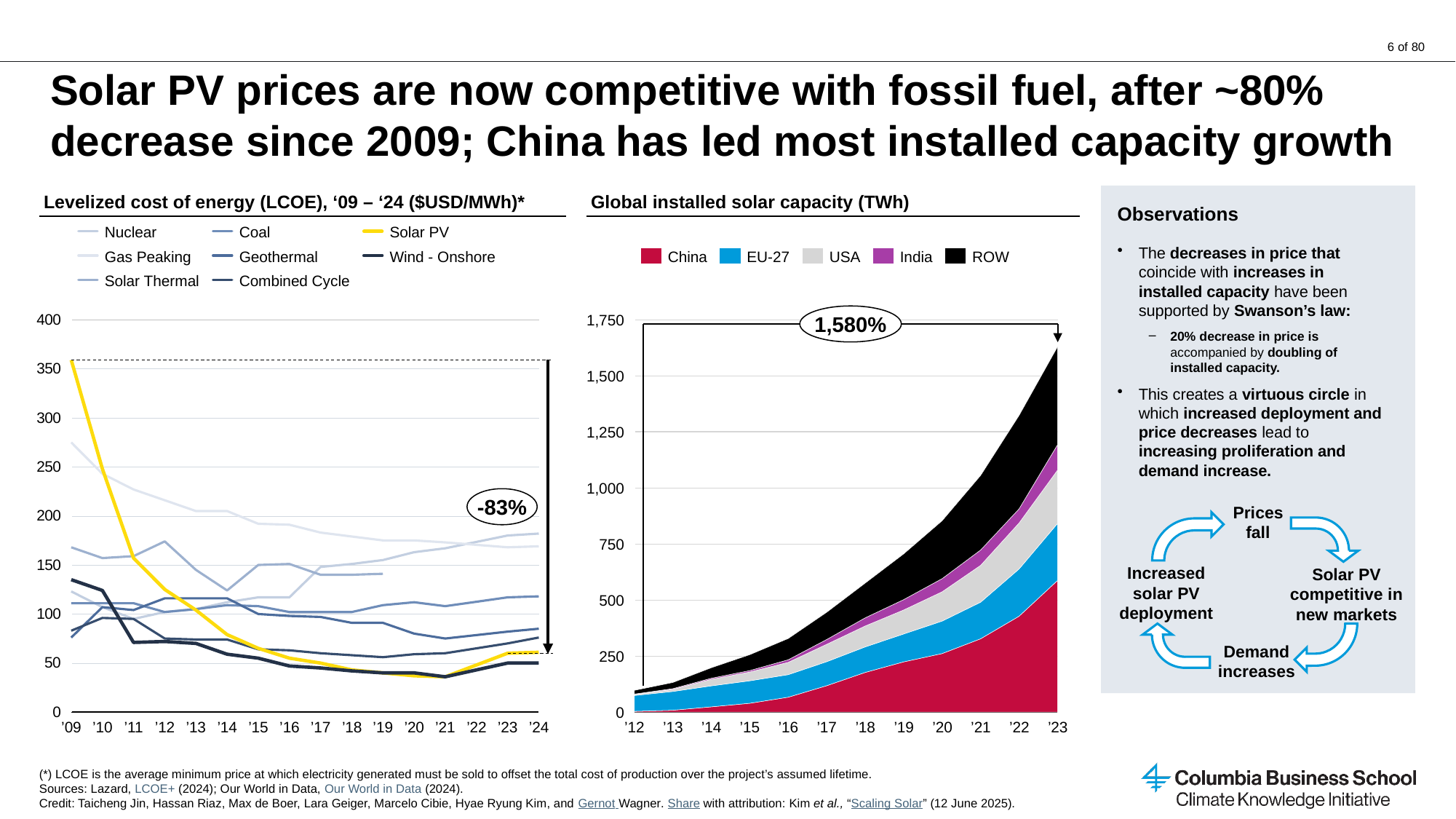
In the 'Levelized cost of energy (LCOE)' chart, is the Solar PV value in '09 greater or less than 300? greater In the 'Levelized cost of energy (LCOE)' chart, which series has the highest value in '09? Solar PV How many years are shown on the x axis of the 'Global installed solar capacity (TWh)' chart? 12 How many years are shown on the x axis of the 'Levelized cost of energy (LCOE)' chart? 16 What kind of chart is the 'Global installed solar capacity (TWh)' chart on the right? Stacked area chart How many series does the legend of the 'Global installed solar capacity (TWh)' chart list? 5 What kind of chart is the 'Levelized cost of energy (LCOE)' chart on the left? Line chart In the 'Levelized cost of energy (LCOE)' chart, does the Solar PV line rise or fall from '09 to '24? Fall How many series does the legend of the 'Levelized cost of energy (LCOE)' chart list? 8 In the 'Global installed solar capacity (TWh)' chart, is the total installed capacity in '23 greater or less than 1,500? greater In the 'Global installed solar capacity (TWh)' chart, does total installed capacity rise or fall from '12 to '23? Rise What percentage change is annotated on the 'Levelized cost of energy (LCOE)' chart for Solar PV? -83%